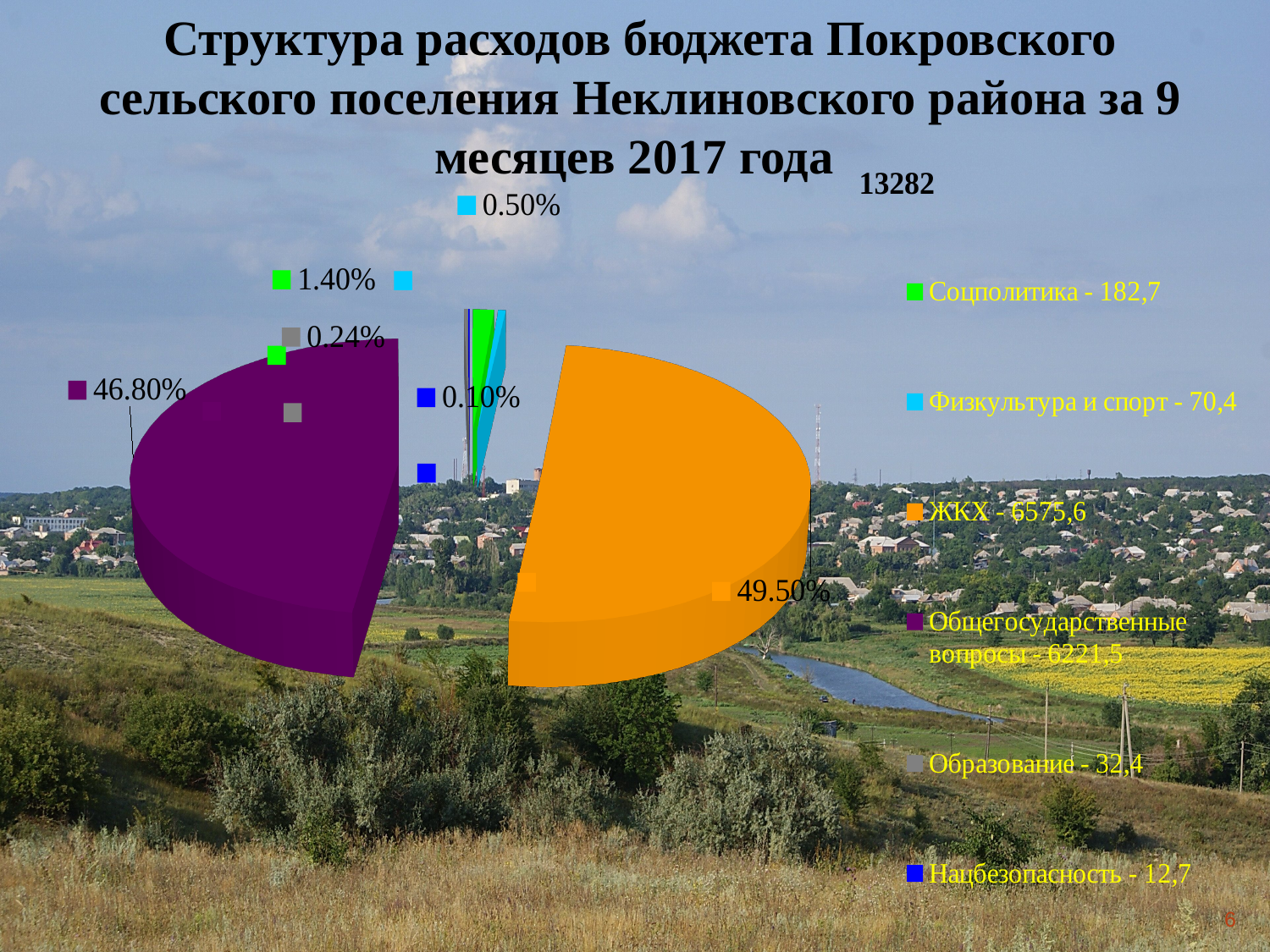
What percentage is labelled for the Нацбезопасность slice? 0.10% What percentage is labelled for the Соцполитика slice? 1.40% Which category has the largest share of the pie? ЖКХ What is the difference in percentage points between the ЖКХ slice and the Общегосударственные вопросы slice? 2.70% What amount is shown in the legend next to Образование? 32,4 Which slice is larger: Образование or Соцполитика? Соцполитика How many categories does the legend list? 6 Which category has the smallest share of the pie? Нацбезопасность What percentage share does the Общегосударственные вопросы slice have? 46.80% What kind of chart is shown on the slide? pie chart What percentage share does the ЖКХ slice have? 49.50% What percentage is labelled for the Физкультура и спорт slice? 0.50%